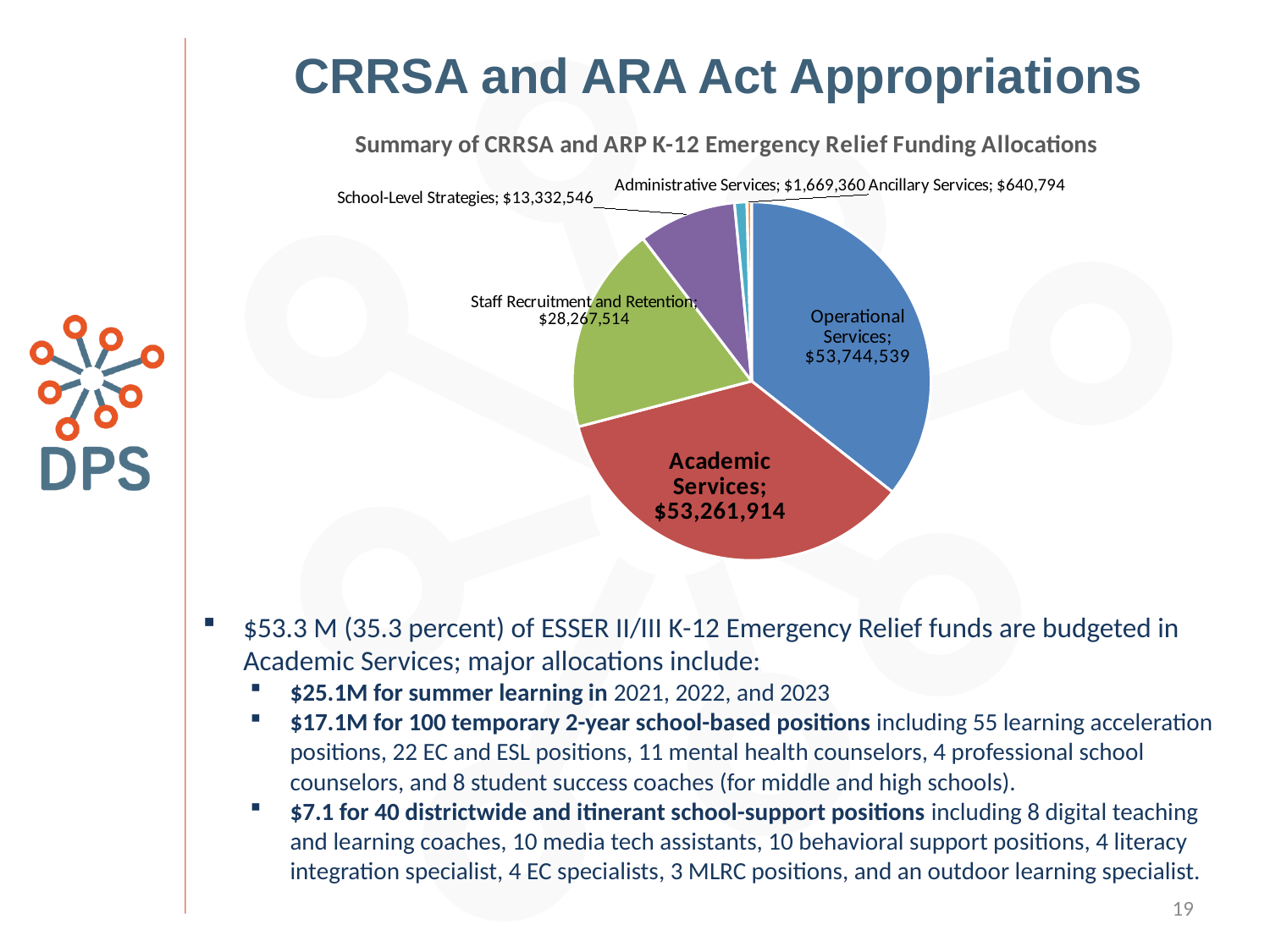
What colour is the Academic Services slice? red What is the title of the chart? Summary of CRRSA and ARP K-12 Emergency Relief Funding Allocations How many slices does the pie chart have? 6 What is the value for Staff Recruitment and Retention? $28,267,514 What is the value for School-Level Strategies? $13,332,546 What is the value for Operational Services? $53,744,539 Which category has the smallest slice of the pie? Ancillary Services What is the difference between Staff Recruitment and Retention and School-Level Strategies? $14,934,968 What is the value for Ancillary Services? $640,794 What type of chart is shown on the slide? pie chart Which is larger, Staff Recruitment and Retention or School-Level Strategies? Staff Recruitment and Retention What is the value for Academic Services? $53,261,914